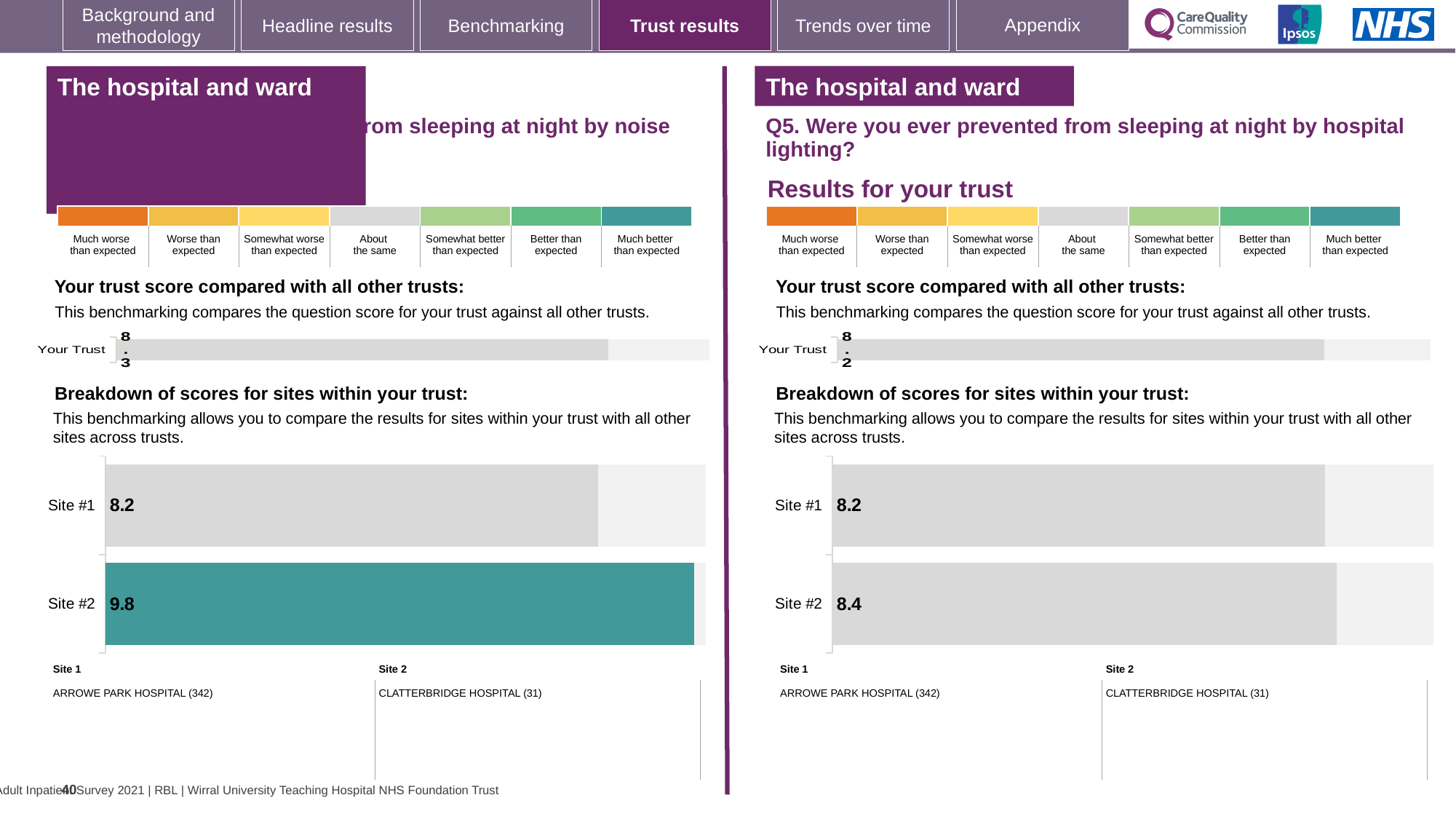
On the left-hand chart (sleeping at night by noise), which site's bar is coloured teal rather than grey? Site #2 On the left-hand chart (sleeping at night by noise), what is the score for Site #2? 9.8 On the left-hand chart (sleeping at night by noise), what is the difference between the Site #2 and Site #1 scores? 1.6 On the left-hand chart (sleeping at night by noise), which site has the higher score? Site #2 On the right-hand chart (Q5, hospital lighting), what is the score for Site #2? 8.4 On the left-hand chart (sleeping at night by noise), what is the 'Your Trust' score? 8.3 On the left-hand chart (sleeping at night by noise), what is the score for Site #1? 8.2 On the right-hand chart (Q5, hospital lighting), what is the difference between the Site #2 and Site #1 scores? 0.2 On the right-hand chart (Q5, hospital lighting), how many sites are shown in the breakdown of scores? 2 What type of chart is used for the breakdown of scores for sites within your trust? Bar chart On the right-hand chart (Q5, hospital lighting), what is the 'Your Trust' score? 8.2 On the right-hand chart (Q5, hospital lighting), what is the score for Site #1? 8.2